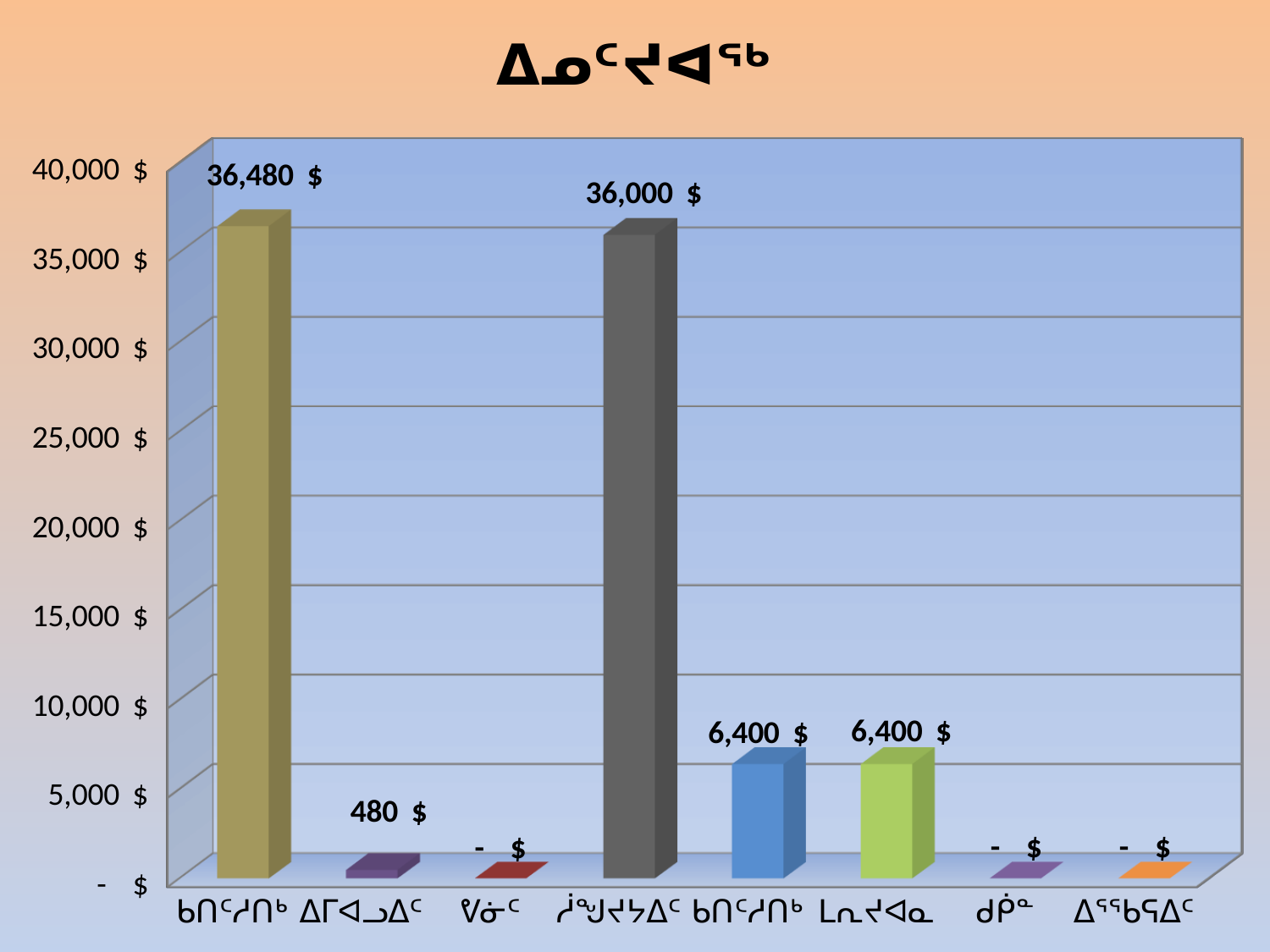
What is the value of the fourth bar from the left (ᓯᖑᔪᔭᐃᑦ)? 36,000 $ How many categories are shown on the x axis of the chart? 8 What is the value of the second bar from the left (ᐃᒥᐊᓗᐃᑦ)? 480 $ What is the value of the first (leftmost) bar in the chart? 36,480 $ What is the value of the sixth bar from the left (ᒪᕆᔪᐊᓇ)? 6,400 $ Which is larger: the value of the second bar (ᐃᒥᐊᓗᐃᑦ) or the fifth bar? the fifth bar (6,400 $) Which bar has the highest value in the chart? the first (leftmost) bar, 36,480 $ How many bars in the chart show a value of "- $"? 3 Is the value of the fourth bar (ᓯᖑᔪᔭᐃᑦ) greater or less than 35,000 $? greater What is the title of the chart? ᐃᓄᑦᔪᐊᖅ What is the difference between the first bar (36,480 $) and the fourth bar (36,000 $)? 480 $ What type of chart is shown on the slide? bar chart